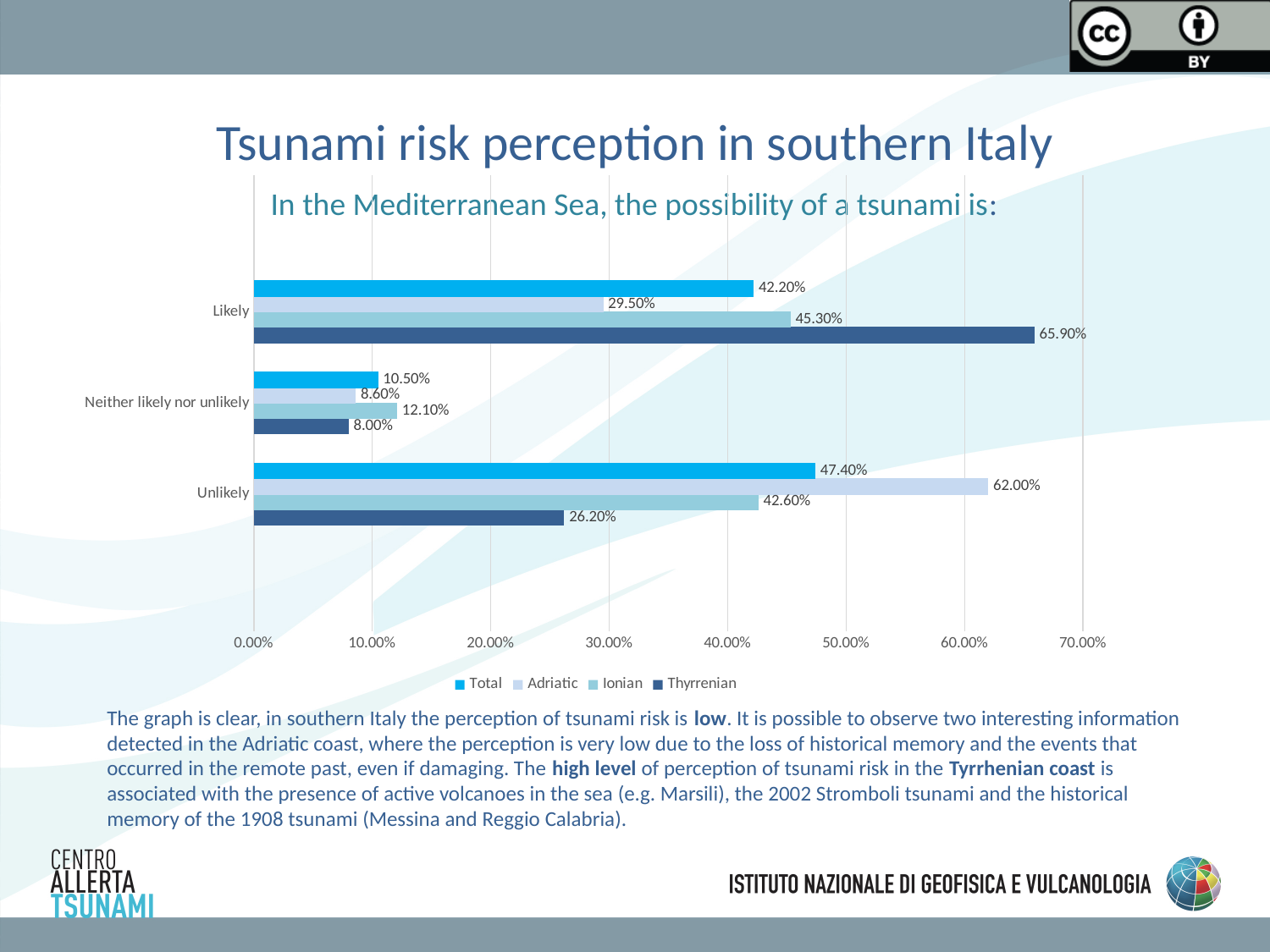
What type of chart is shown on the slide? Bar chart What is the difference between the Adriatic and Thyrrenian values for "Unlikely"? 35.80% Which is larger for "Likely": the Total value or the Adriatic value? Total What is the Thyrrenian value for "Likely"? 65.90% What is the Adriatic value for "Unlikely"? 62.00% What is the Ionian value for "Likely"? 45.30% Is the Total value for "Unlikely" greater or less than 40.00%? greater What is the Total value for "Neither likely nor unlikely"? 10.50% How many series does the legend list? 4 How many categories are shown on the vertical axis? 3 Which series has the lowest value for "Unlikely"? Thyrrenian Which series has the highest value for "Likely"? Thyrrenian